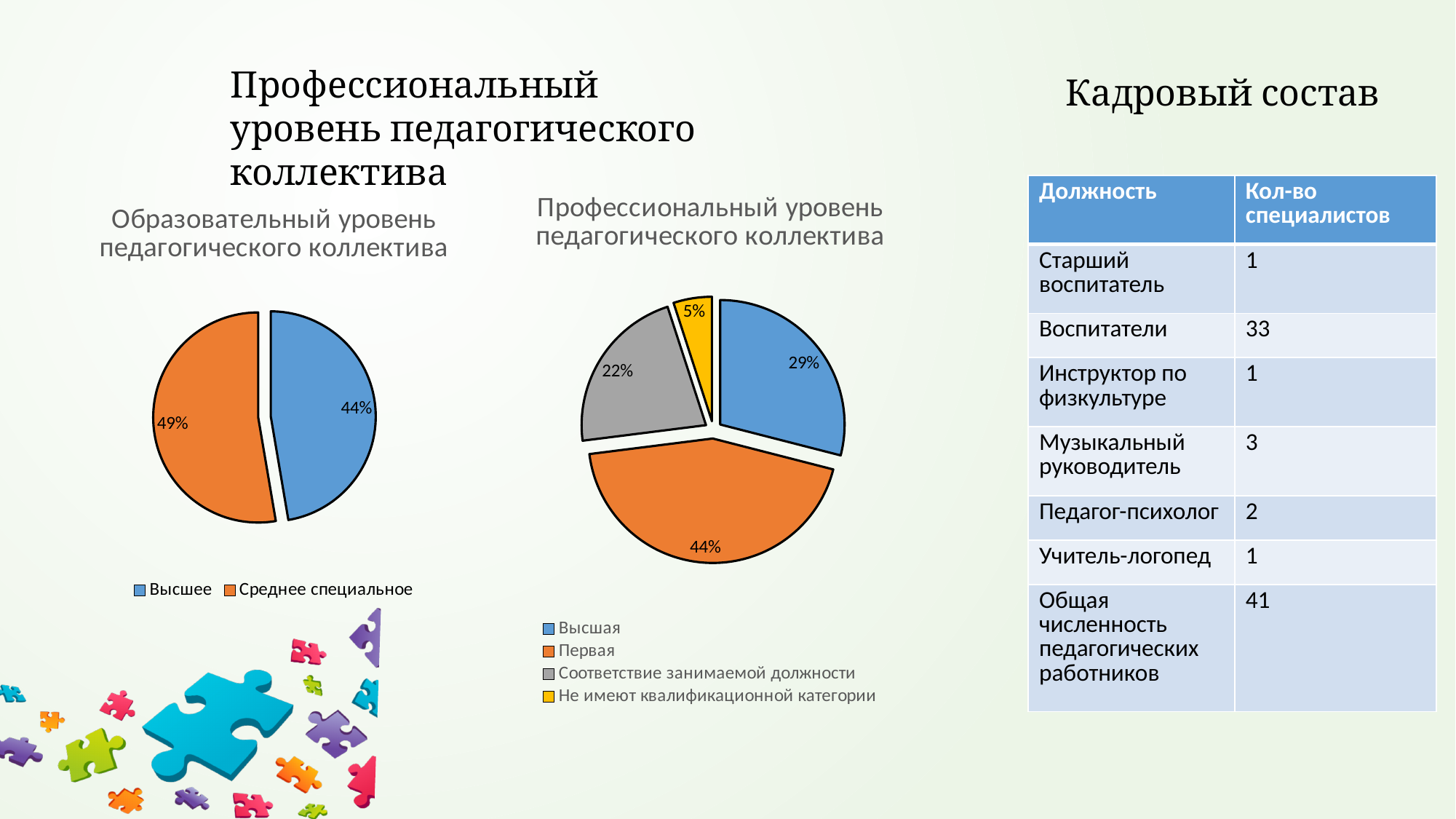
In the chart 'Образовательный уровень педагогического коллектива', what percentage is shown for 'Среднее специальное'? 49% In the chart 'Профессиональный уровень педагогического коллектива', which colour represents 'Не имеют квалификационной категории'? Yellow In the chart 'Профессиональный уровень педагогического коллектива', how many categories does the legend list? 4 In the chart 'Профессиональный уровень педагогического коллектива', what percentage is shown for 'Соответствие занимаемой должности'? 22% In the chart 'Профессиональный уровень педагогического коллектива', what is the difference in percentage points between 'Первая' and 'Высшая'? 15 In the chart 'Профессиональный уровень педагогического коллектива', which category has the largest share? Первая In the chart 'Образовательный уровень педагогического коллектива', which category has the larger share? Среднее специальное In the chart 'Образовательный уровень педагогического коллектива', what is the difference in percentage points between 'Среднее специальное' and 'Высшее'? 5 In the chart 'Профессиональный уровень педагогического коллектива', which category has the smallest share? Не имеют квалификационной категории What kind of chart is 'Образовательный уровень педагогического коллектива'? Pie chart In the chart 'Образовательный уровень педагогического коллектива', what percentage is shown for 'Высшее'? 44% In the chart 'Профессиональный уровень педагогического коллектива', what percentage is shown for 'Первая'? 44%